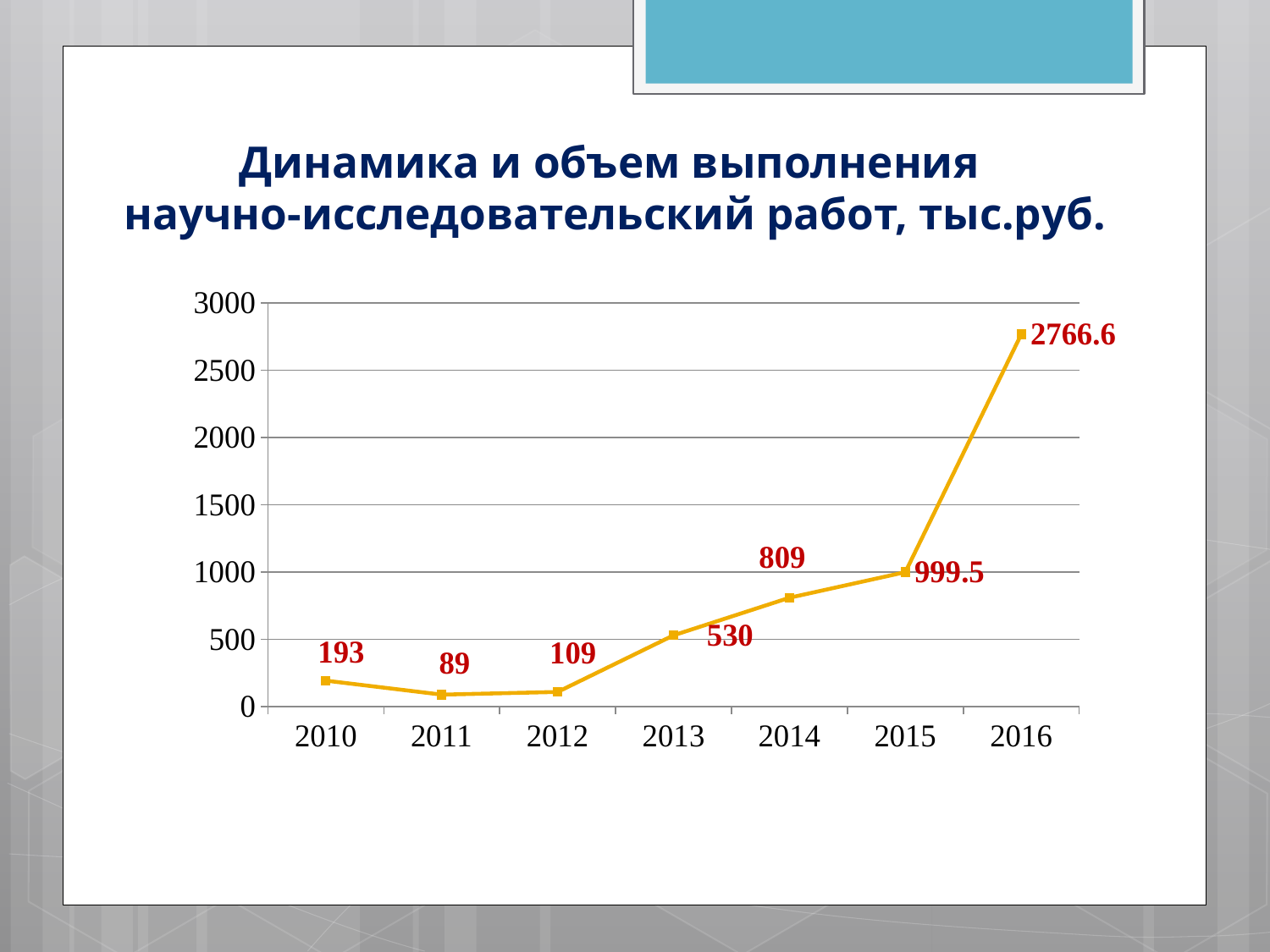
Is the value for 2014 greater or less than 1000? less Which is larger, the value for 2010 or the value for 2012? 2010 What is the value for 2016? 2766.6 What is the value for 2011? 89 Do the values rise or fall from 2012 to 2016? rise What kind of chart is shown on the slide? line chart How many years are plotted on the chart? 7 What is the difference between the values for 2014 and 2013? 279 Which year has the lowest value? 2011 Which year has the highest value? 2016 What is the value for 2015? 999.5 What is the value for 2013? 530